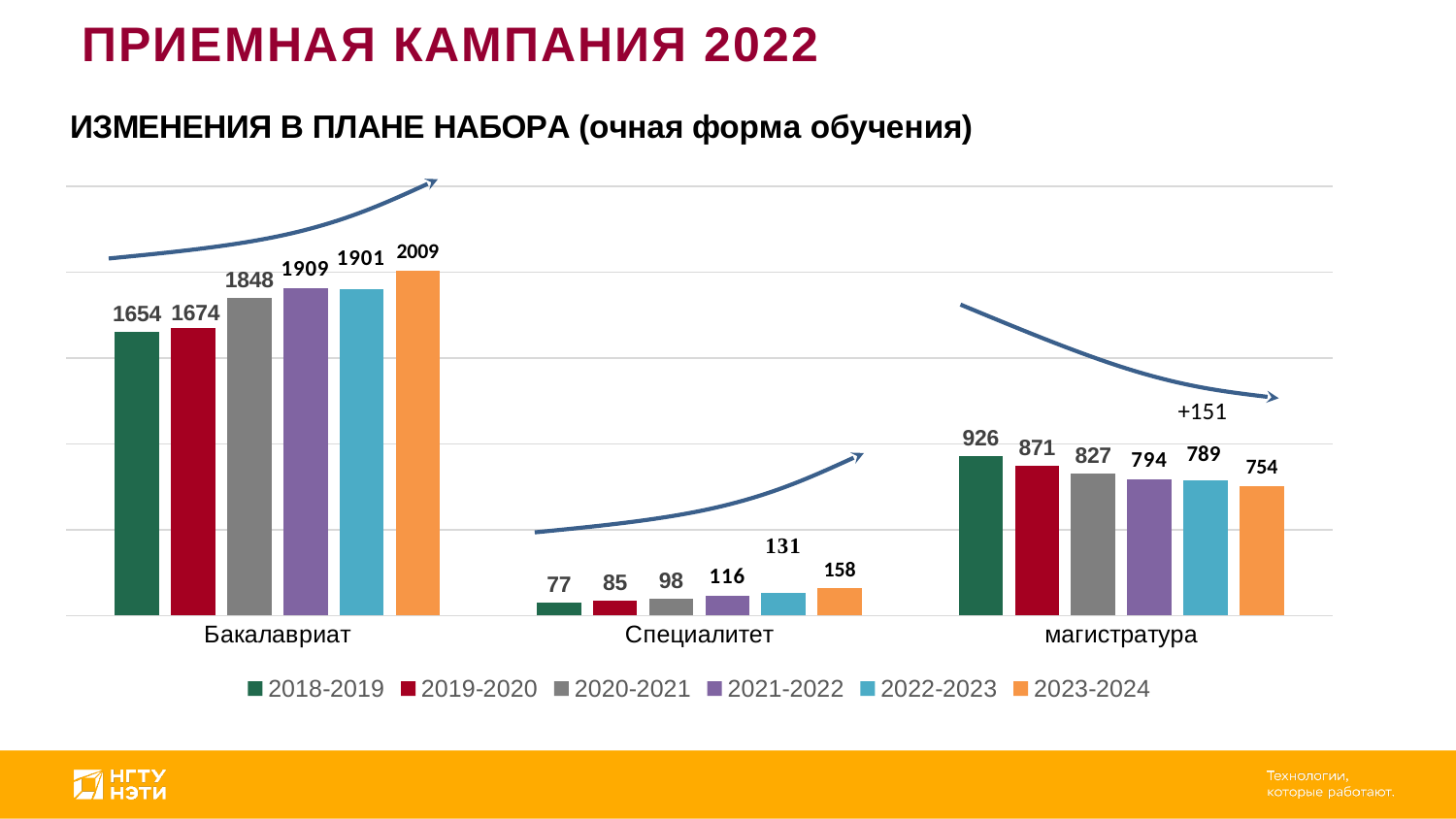
How many categories are shown on the x axis? 3 What is the difference between the 2023-2024 and 2018-2019 values for Специалитет? 81 Do the values for магистратура rise or fall from the 2018-2019 series to the 2023-2024 series? fall What is the value for Специалитет in the 2018-2019 series? 77 Which series has the highest value for магистратура? 2018-2019 What is the value for магистратура in the 2021-2022 series? 794 What is the value for Бакалавриат in the 2023-2024 series? 2009 What kind of chart is shown on the slide? bar chart Which series has the lowest value for Бакалавриат? 2018-2019 What is the difference between the 2018-2019 and 2023-2024 values for магистратура? 172 Which is larger for Бакалавриат: the 2020-2021 value or the 2021-2022 value? 2021-2022 How many series does the legend list? 6